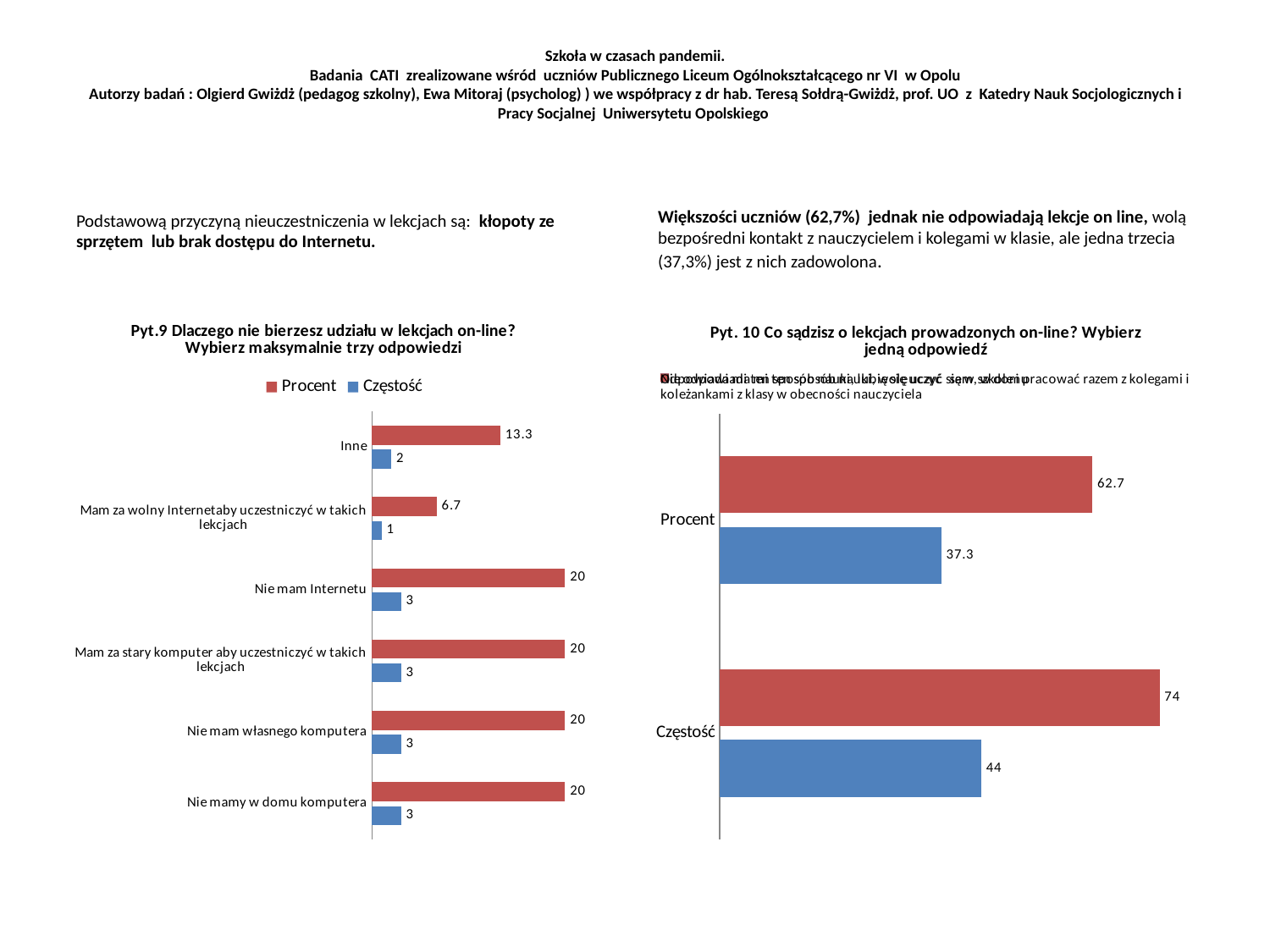
In the Pyt. 10 chart, what is the difference between the red and blue bars for Częstość? 30 In the Pyt.9 chart, what is the Częstość value for "Nie mam Internetu"? 3 In the Pyt.9 chart, what is the Procent value for "Mam za wolny Internet aby uczestniczyć w takich lekcjach"? 6.7 In the Pyt.9 chart, how many categories are shown? 6 In the Pyt.9 chart, what is the Procent value for "Inne"? 13.3 In the Pyt.9 chart, which category has the lowest Procent value? Mam za wolny Internet aby uczestniczyć w takich lekcjach In the Pyt.9 chart, how many series does the legend list? 2 What kind of chart is the Pyt. 10 chart? bar chart In the Pyt. 10 chart, what is the value of the blue bar for Częstość? 44 In the Pyt.9 chart, what is the difference between the Procent values for "Inne" and "Mam za wolny Internet aby uczestniczyć w takich lekcjach"? 6.6 In the Pyt.9 chart, which series is shown in blue? Częstość In the Pyt. 10 chart, what is the value of the red bar for Procent? 62.7